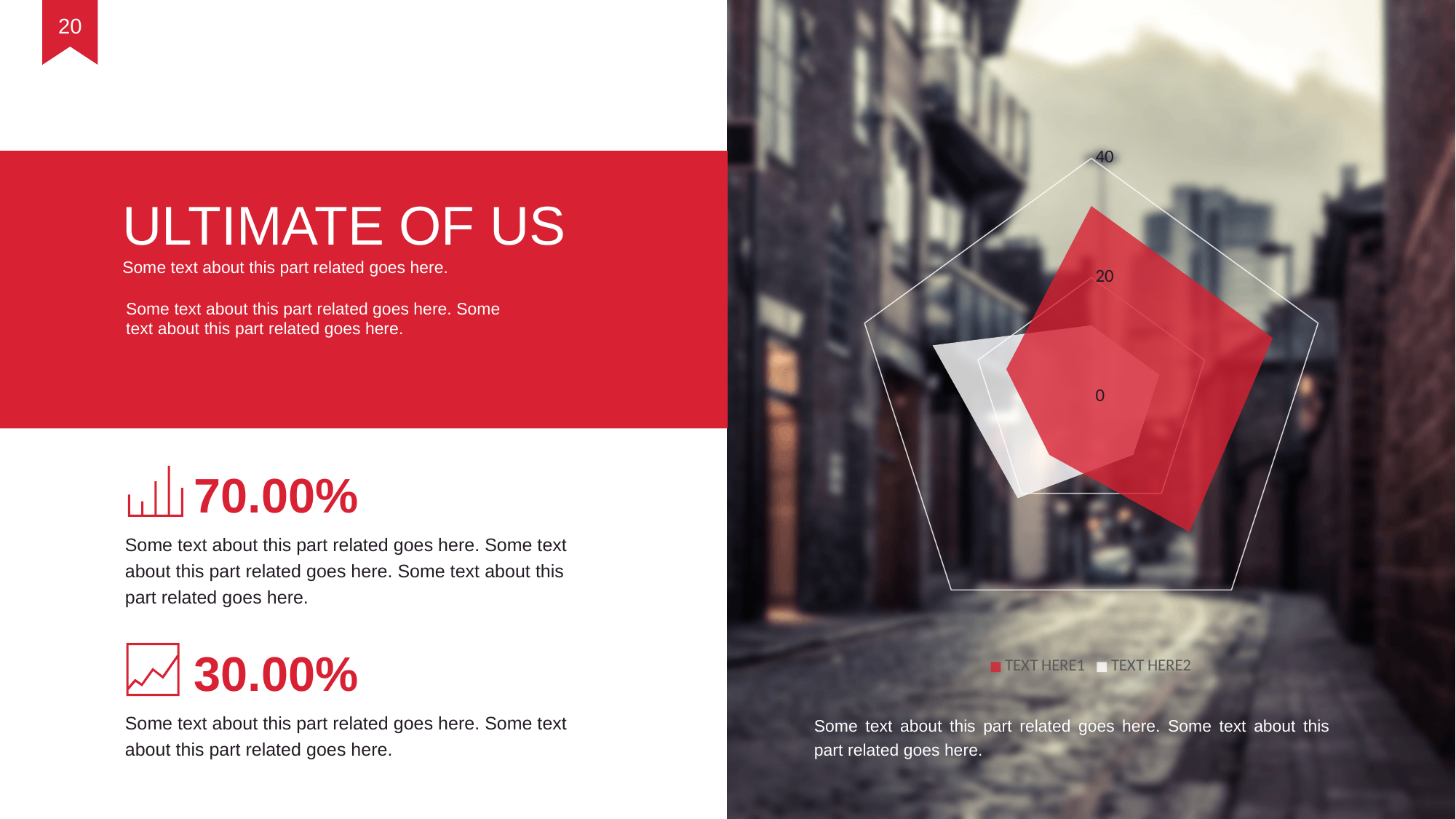
How many axes (points) does the radar chart have? 5 How many series does the legend of the radar chart list? 2 What kind of chart is shown on the right side of the slide? Radar chart What are the two legend entries of the radar chart? TEXT HERE1 and TEXT HERE2 Which colour represents the series TEXT HERE1 in the radar chart? Red What is the highest value shown on the radar chart's axis scale? 40 Which series covers the larger area in the radar chart, TEXT HERE1 or TEXT HERE2? TEXT HERE1